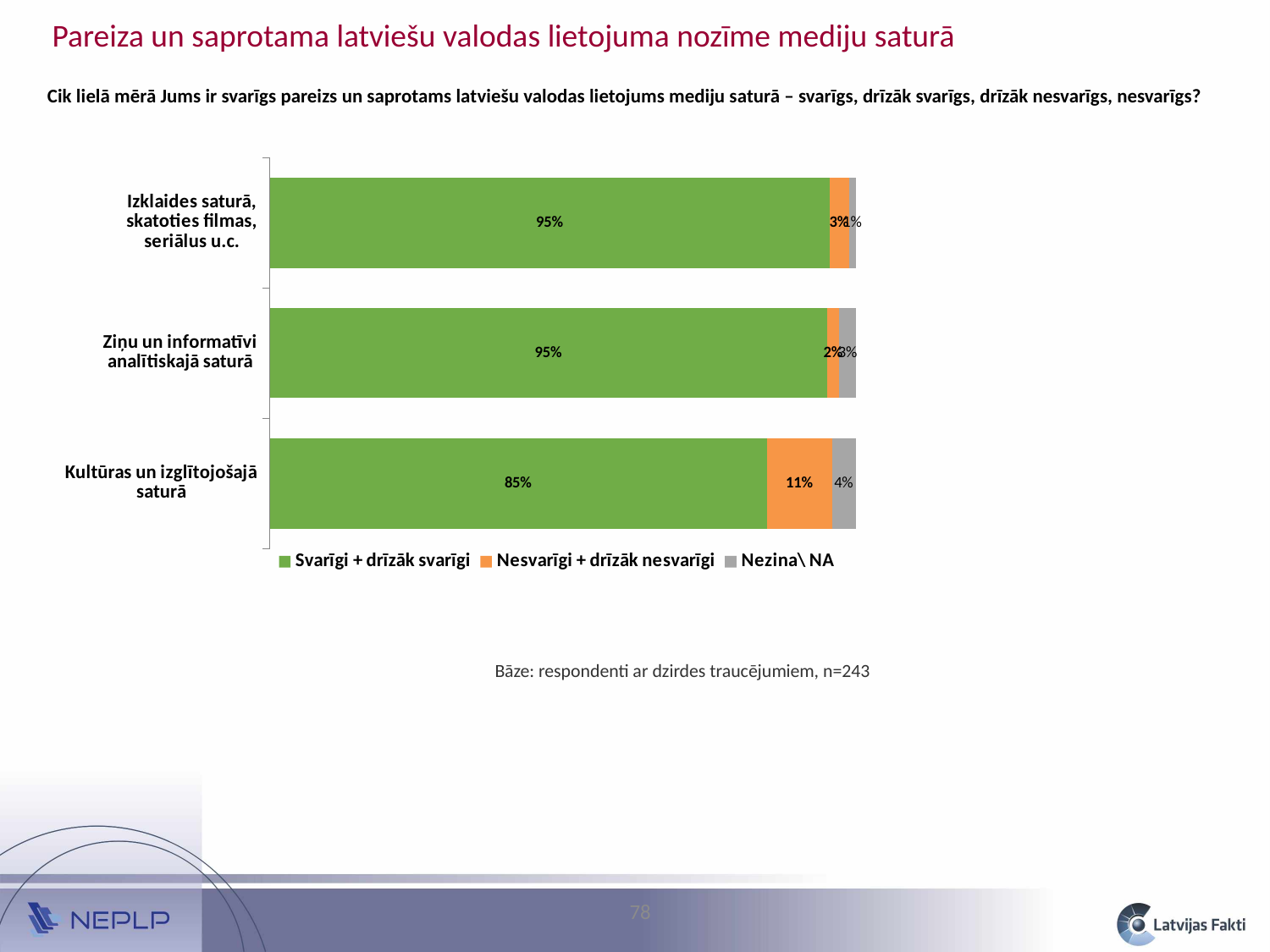
Which colour represents the 'Nezina\ NA' series in the legend? Grey Which category has the highest value for 'Nesvarīgi + drīzāk nesvarīgi'? Kultūras un izglītojošajā saturā Which category has the lowest value for 'Svarīgi + drīzāk svarīgi'? Kultūras un izglītojošajā saturā What is the value of 'Svarīgi + drīzāk svarīgi' for 'Kultūras un izglītojošajā saturā'? 85% What is the difference between the 'Svarīgi + drīzāk svarīgi' values for 'Izklaides saturā, skatoties filmas, seriālus u.c.' and 'Kultūras un izglītojošajā saturā'? 10% How many series does the legend list? 3 What is the value of 'Svarīgi + drīzāk svarīgi' for 'Ziņu un informatīvi analītiskajā saturā'? 95% Which is larger: the 'Nesvarīgi + drīzāk nesvarīgi' value for 'Kultūras un izglītojošajā saturā' or for 'Izklaides saturā, skatoties filmas, seriālus u.c.'? Kultūras un izglītojošajā saturā What is the value of 'Nezina\ NA' for 'Kultūras un izglītojošajā saturā'? 4% What kind of chart is shown on the slide? Stacked bar chart How many categories are shown on the chart? 3 What is the value of 'Nesvarīgi + drīzāk nesvarīgi' for 'Kultūras un izglītojošajā saturā'? 11%